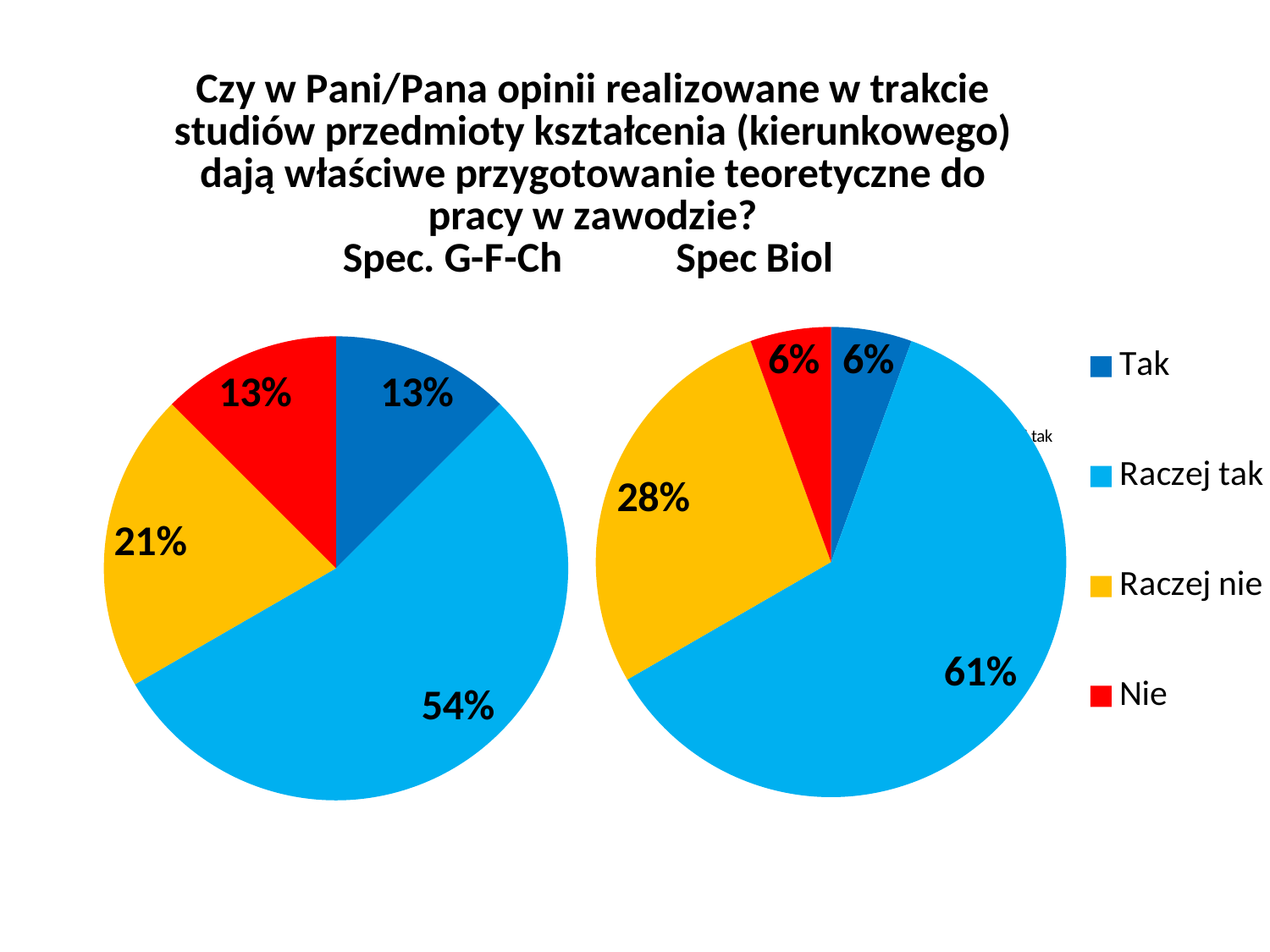
What type of chart is used on this slide? Pie chart In the Spec Biol pie chart (right), which category has the largest slice? Raczej tak How many slices does the Spec Biol pie chart (right) have? 4 In the Spec. G-F-Ch pie chart (left), which category has the smallest slice? Tak and Nie (tied at 13%) Which chart has the larger Nie share, Spec. G-F-Ch (left) or Spec Biol (right)? Spec. G-F-Ch In the Spec Biol pie chart (right), what share is labelled for Raczej tak? 61% In the Spec. G-F-Ch pie chart (left), what is the difference between the Raczej tak and Raczej nie shares? 33% In the Spec. G-F-Ch pie chart (left), which category has the largest slice? Raczej tak What is the difference between the Raczej tak shares in the Spec Biol chart (right) and the Spec. G-F-Ch chart (left)? 7% In the Spec Biol pie chart (right), what share is labelled for Raczej nie? 28% In the Spec. G-F-Ch pie chart (left), what share is labelled for Raczej tak? 54% In the Spec. G-F-Ch pie chart (left), what share is labelled for Raczej nie? 21%